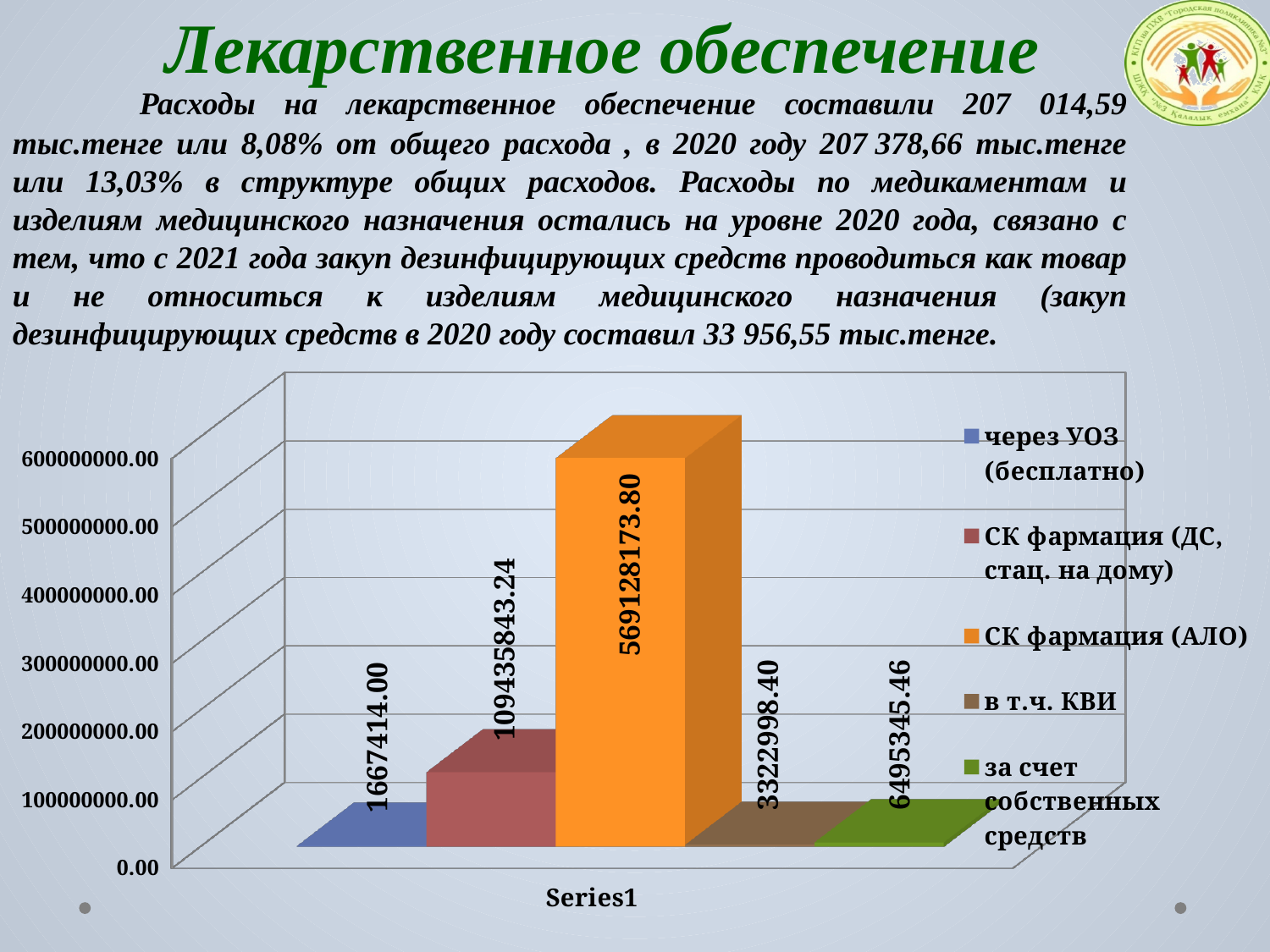
What is the difference between the value for СК фармация (АЛО) and the value for СК фармация (ДС, стац. на дому)? 459692330.56 What is the value for в т.ч. КВИ? 3322998.40 What is the category label shown on the x axis of the chart? Series1 What type of chart is shown on the slide? bar chart Which is larger: the value for в т.ч. КВИ or the value for за счет собственных средств? за счет собственных средств What is the value for СК фармация (ДС, стац. на дому)? 109435843.24 Which series has the lowest value? через УОЗ (бесплатно) Which series has the highest value? СК фармация (АЛО) What is the value for через УОЗ (бесплатно)? 1667414.00 What is the value for СК фармация (АЛО)? 569128173.80 How many series does the chart legend list? 5 What is the value for за счет собственных средств? 6495345.46